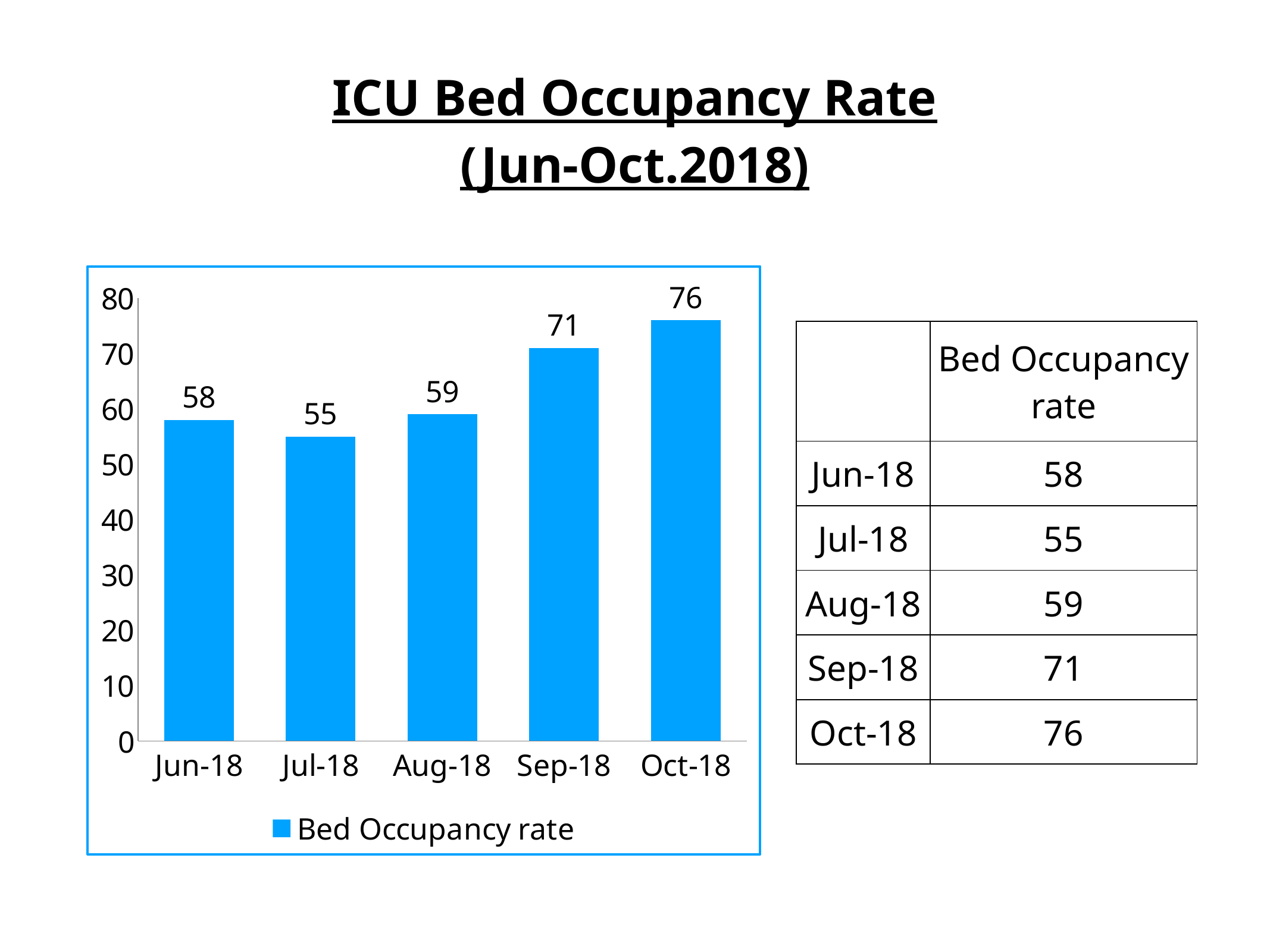
What is the bed occupancy rate for Oct-18? 76 What kind of chart is shown on the slide? Bar chart What is the bed occupancy rate for Sep-18? 71 What is the difference between the bed occupancy rate in Sep-18 and Aug-18? 12 How many months are shown on the chart? 5 Which month has the highest bed occupancy rate? Oct-18 What series name does the legend show? Bed Occupancy rate What is the bed occupancy rate for Jun-18? 58 Which month has the lowest bed occupancy rate? Jul-18 Which is larger, the bed occupancy rate for Aug-18 or Jul-18? Aug-18 Is the bed occupancy rate for Sep-18 greater or less than 60? greater What is the difference between the bed occupancy rate in Oct-18 and Jun-18? 18